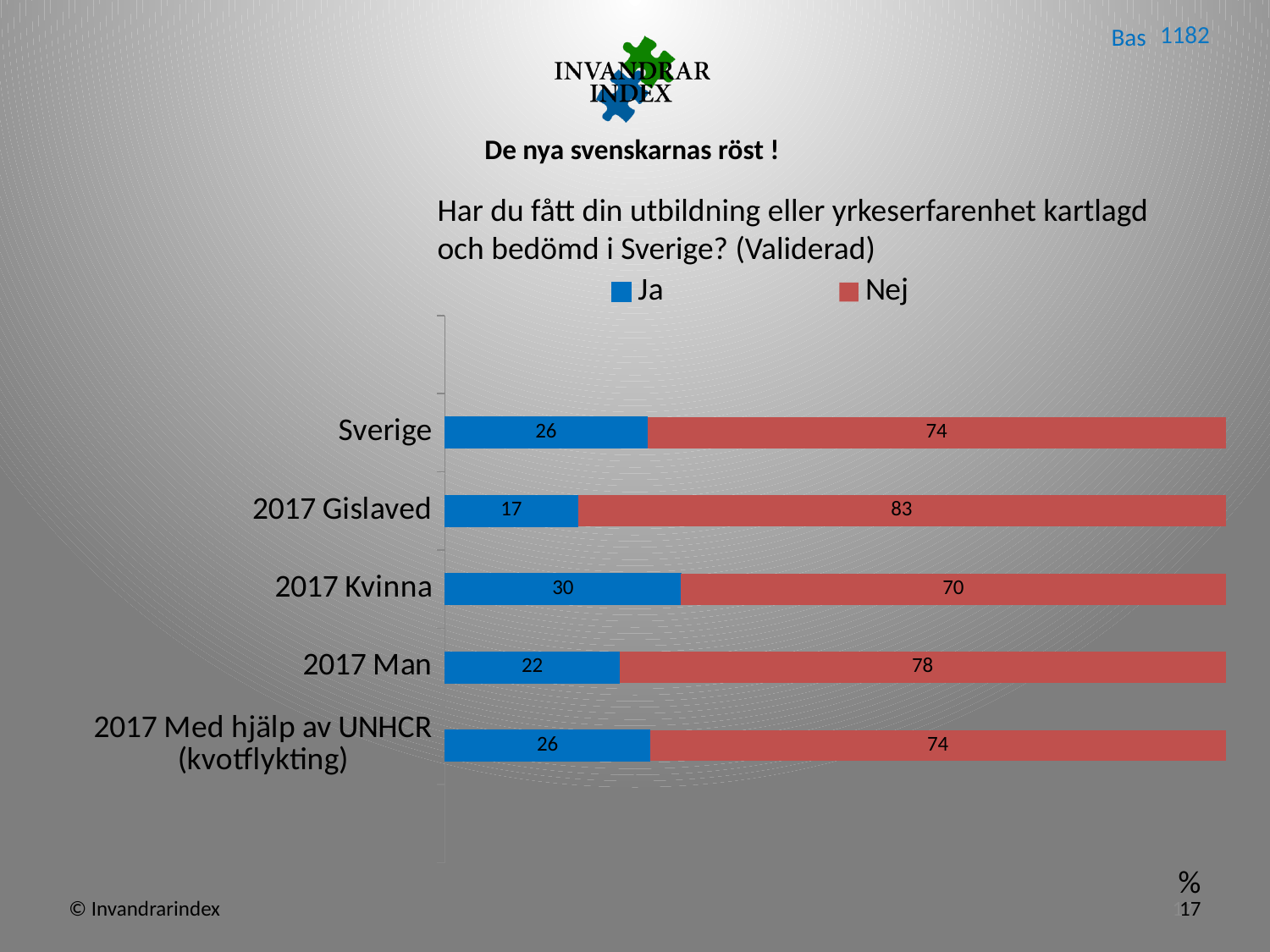
What is the difference between the "Ja" values for 2017 Kvinna and 2017 Man? 8 What is the "Ja" value for 2017 Kvinna? 30 Which is larger, the "Nej" value for 2017 Gislaved or for 2017 Kvinna? 2017 Gislaved What is the "Ja" value for Sverige? 26 What kind of chart is shown on the slide? Stacked bar chart How many categories are shown in the chart? 5 What is the "Nej" value for 2017 Gislaved? 83 Which category has the highest "Ja" value? 2017 Kvinna Which category has the lowest "Ja" value? 2017 Gislaved What is the "Nej" value for 2017 Man? 78 How many series does the legend list? 2 What is the total of the stacked bar for 2017 Med hjälp av UNHCR (kvotflykting)? 100